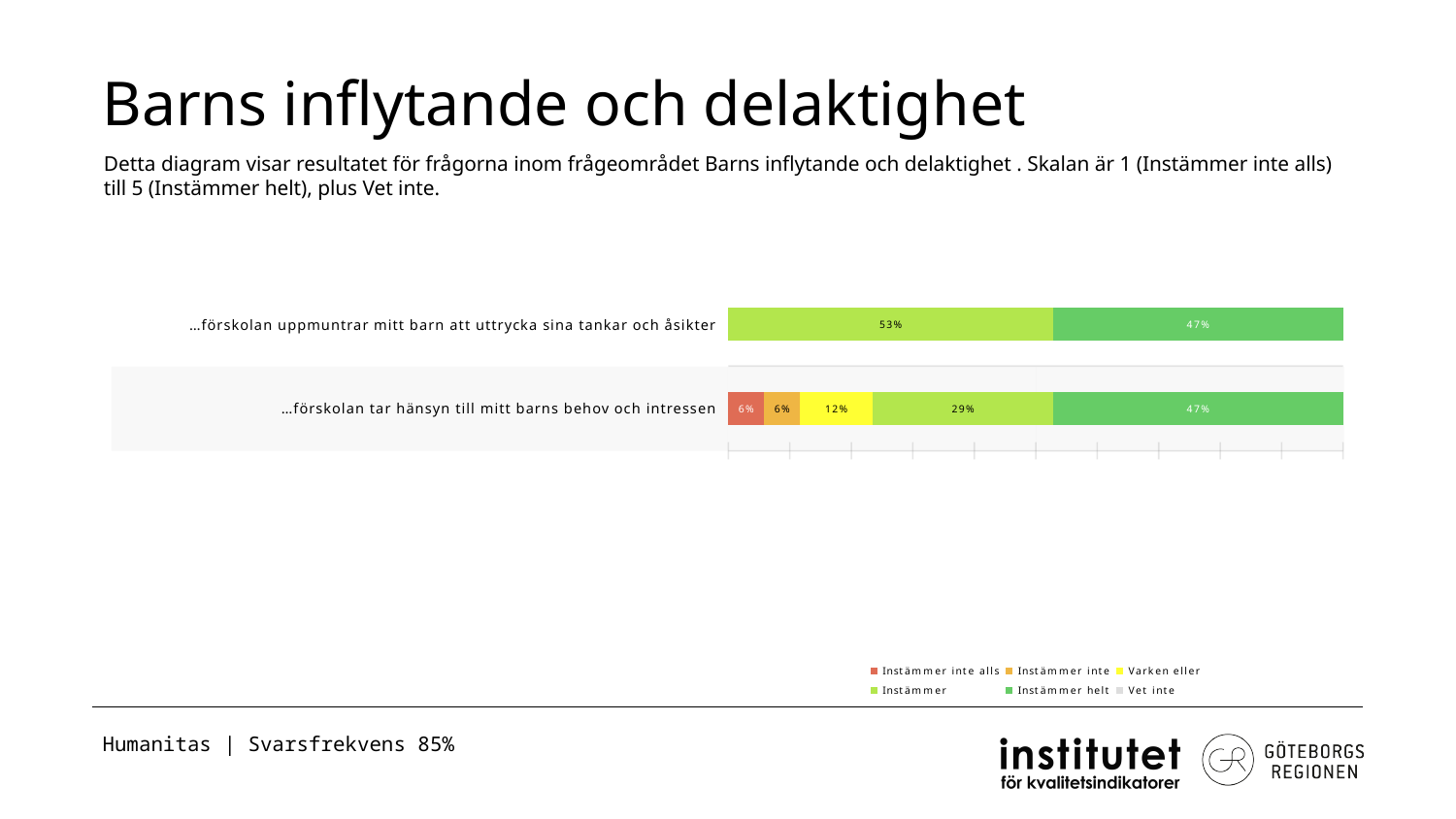
What is the 'Instämmer inte alls' share for '…förskolan tar hänsyn till mitt barns behov och intressen'? 6% How many categories (statements) are plotted in the chart? 2 What is the combined share of 'Instämmer' and 'Instämmer helt' for '…förskolan tar hänsyn till mitt barns behov och intressen'? 76% Which statement has the larger 'Instämmer' share? …förskolan uppmuntrar mitt barn att uttrycka sina tankar och åsikter What kind of chart is shown on the slide? Stacked bar chart What is the 'Instämmer' share for '…förskolan tar hänsyn till mitt barns behov och intressen'? 29% What is the difference between the 'Instämmer' shares of the two statements (53% vs 29%)? 24% What is the 'Varken eller' share for '…förskolan tar hänsyn till mitt barns behov och intressen'? 12% What is the 'Instämmer' share for '…förskolan uppmuntrar mitt barn att uttrycka sina tankar och åsikter'? 53% What is the 'Instämmer helt' share for '…förskolan uppmuntrar mitt barn att uttrycka sina tankar och åsikter'? 47% How many series does the legend list? 6 Which legend entry is shown in yellow? Varken eller